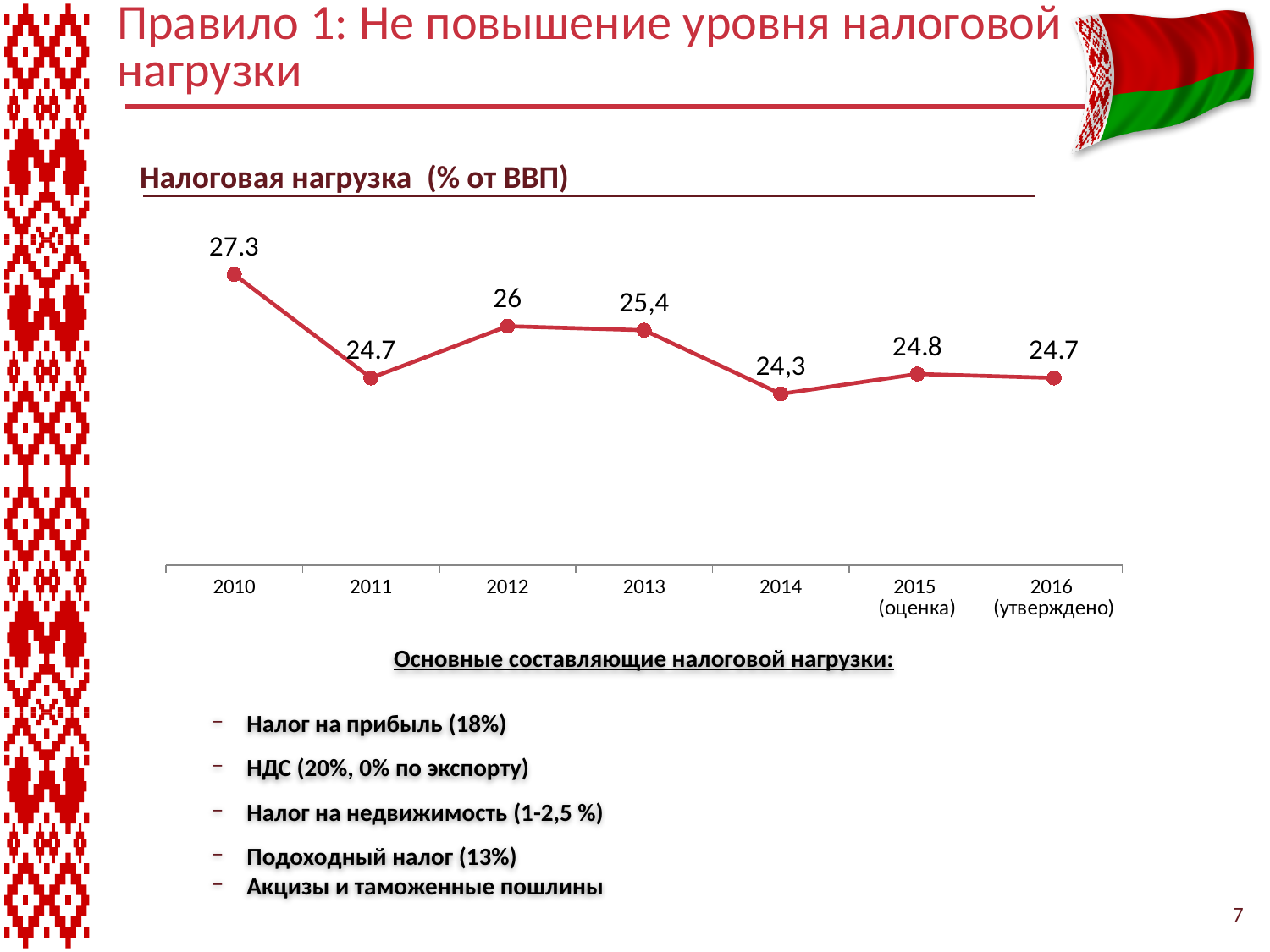
What is the title of the chart? Налоговая нагрузка (% от ВВП) What is the tax burden value for 2010? 27.3 Which is larger, the value for 2012 or the value for 2013? 2012 What is the tax burden value for 2013? 25,4 Which year has the lowest tax burden value? 2014 What is the difference between the values for 2010 and 2011? 2.6 What is the value shown for 2016 (утверждено)? 24.7 What kind of chart is shown on the slide? Line chart What is the value shown for 2015 (оценка)? 24.8 Does the value rise or fall from 2013 to 2014? Fall How many data points are plotted on the chart? 7 Which year has the highest tax burden value? 2010